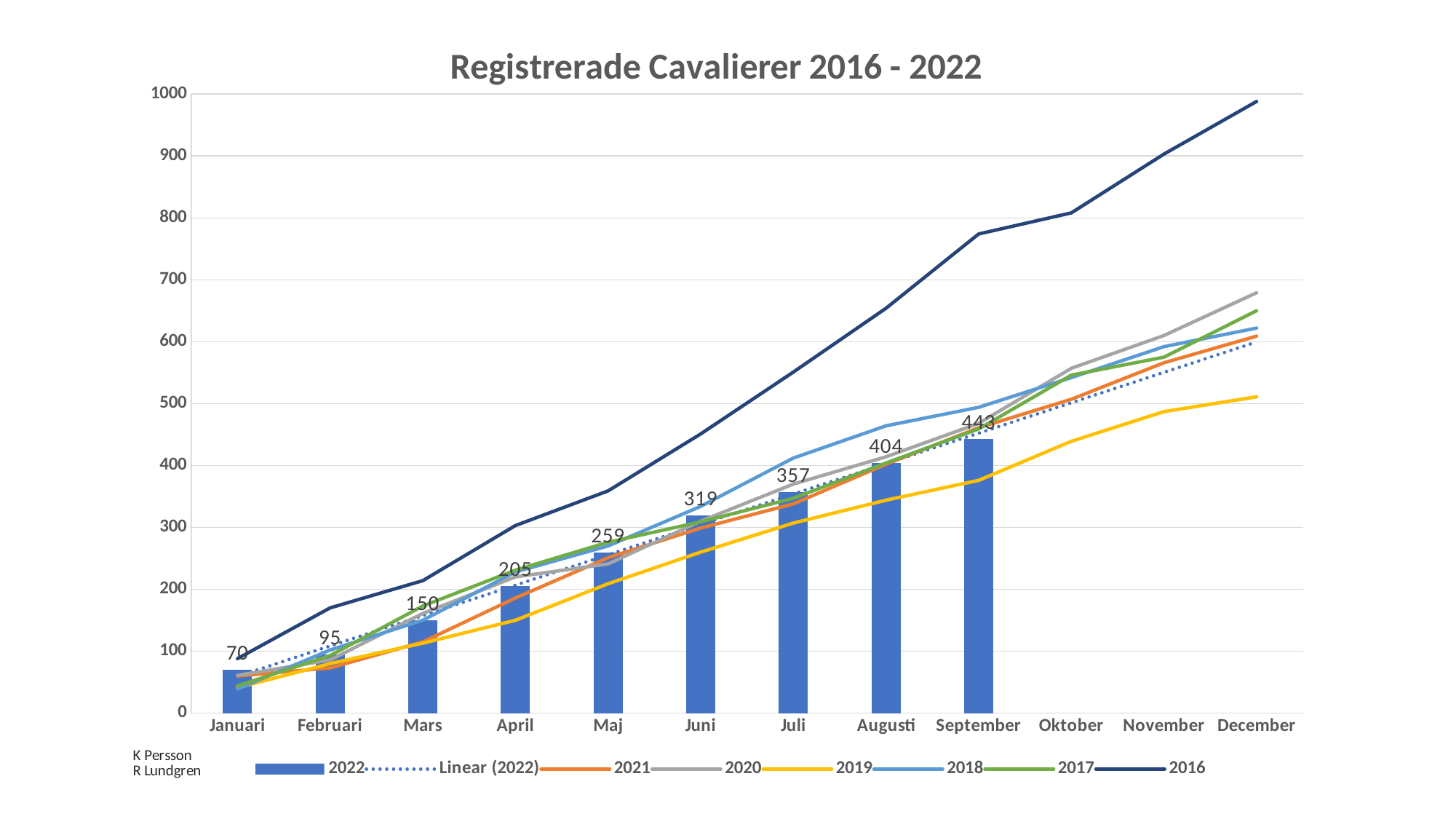
What is the 2022 value for Mars? 150 Which is larger for 2022: the value for Augusti or the value for Juli? Augusti What is the difference between the 2022 values for September and Januari? 373 In which month does the 2022 series reach its highest value? September What is the 2022 value for Juli? 357 What is the title of the chart? Registrerade Cavalierer 2016 - 2022 How many months are shown on the x axis? 12 How many entries does the legend list? 8 Is the 2019 value for December greater or less than 600? less Is the 2016 value for December greater or less than 900? greater Does the 2016 line rise or fall from Januari to December? rises In which month is the 2022 value lowest? Januari